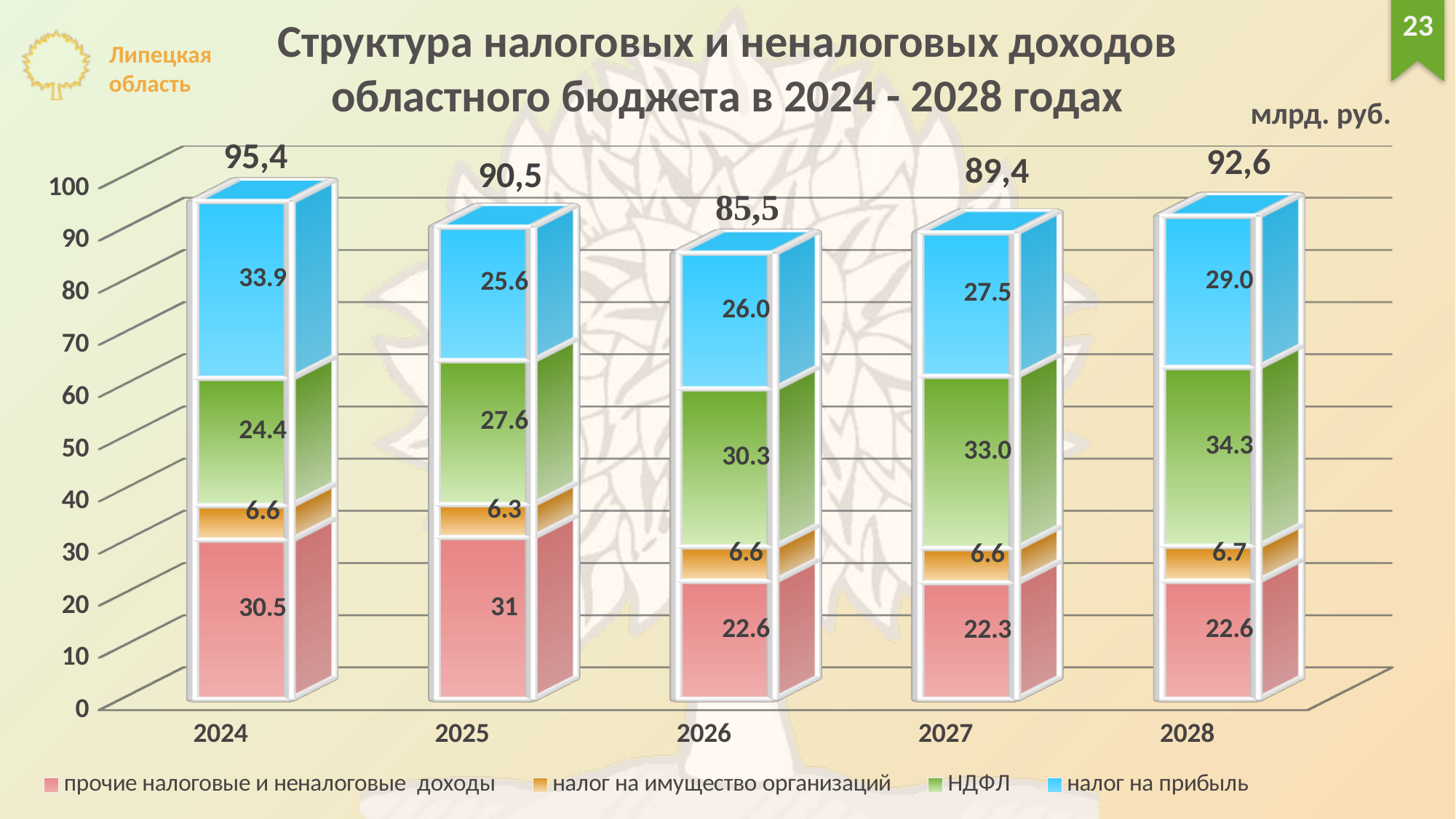
What is the total shown above the bar for 2026? 85,5 What unit is indicated in the top right corner of the chart? млрд. руб. How many years are shown on the x axis? 5 Which year has the highest total? 2024 Which year has the lowest total? 2026 How many series does the legend list? 4 What kind of chart is shown on the slide? stacked bar chart What is the value of прочие налоговые и неналоговые доходы for 2025? 31 Which is larger, налог на прибыль in 2025 or in 2026? 2026 What is the value of НДФЛ for 2028? 34.3 What is the difference between the НДФЛ values for 2027 and 2024? 8.6 What is the value of налог на прибыль for 2024? 33.9